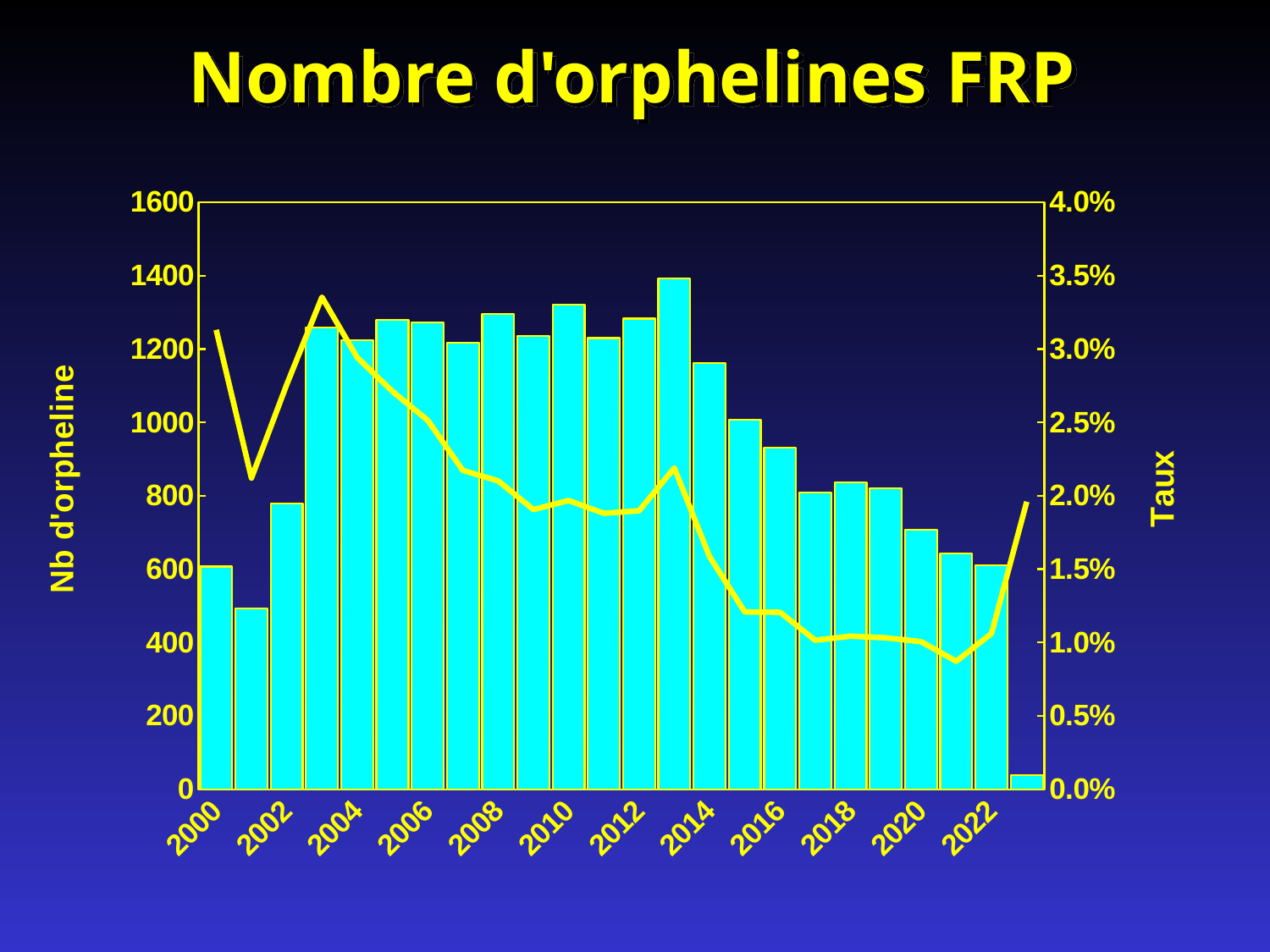
Does the Taux line rise or fall between 2013 and 2015? fall How many bars are plotted in the chart? 24 Is the Taux value in 2003 greater or less than 3.0%? greater Is the number of orphelines in 2001 greater or less than 600? less Is the number of orphelines in 2013 greater or less than 1200? greater What is the title of the chart? Nombre d'orphelines FRP In which year is the bar for the number of orphelines the highest? 2013 What is the label of the right-hand vertical axis? Taux Which year has a higher number of orphelines, 2000 or 2001? 2000 What kind of chart is shown on the slide? A bar chart combined with a line chart In which year is the bar for the number of orphelines the lowest? 2023